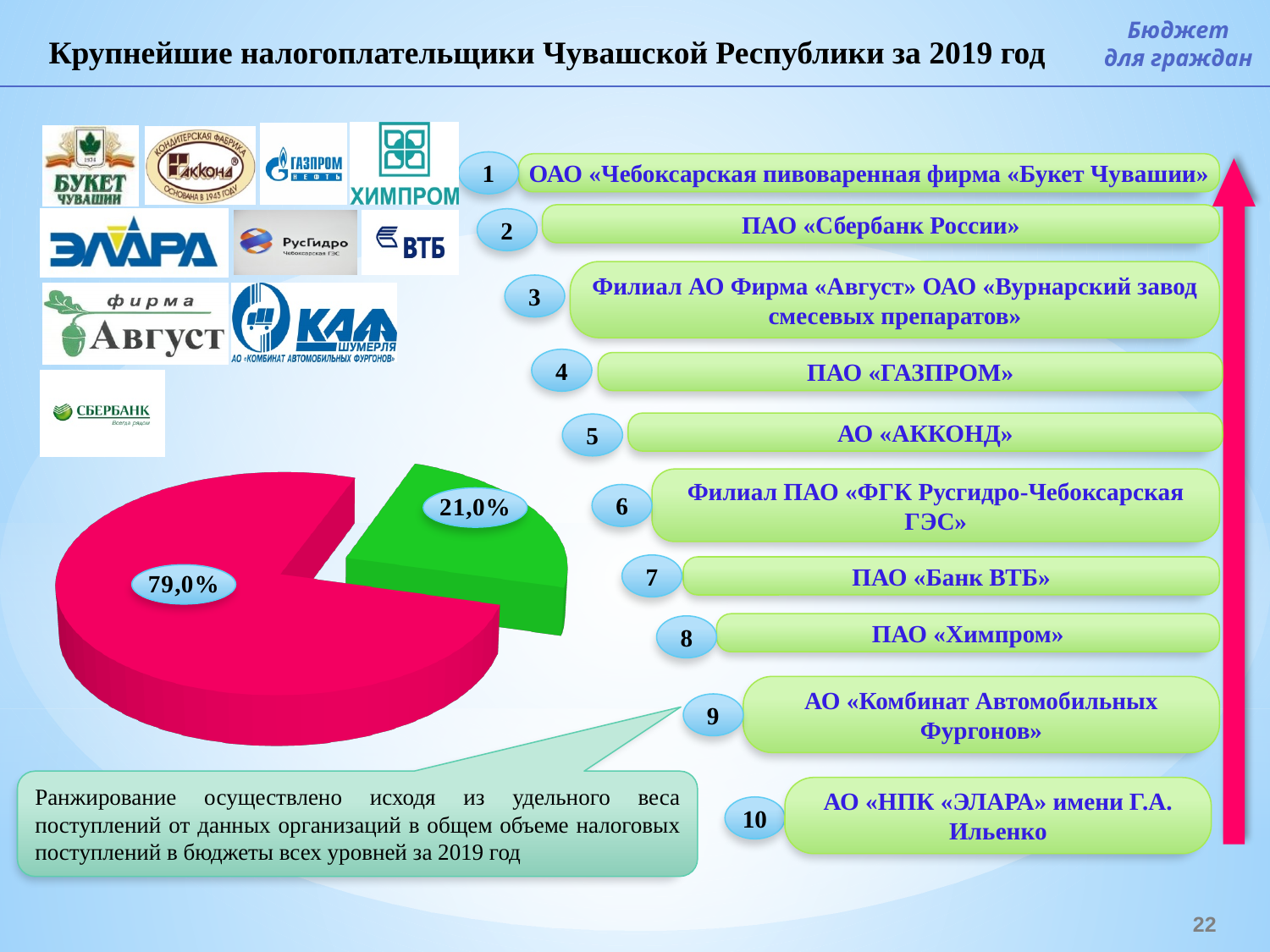
What is the difference between the pink slice and the green slice of the pie chart? 58,0% Which slice of the pie chart is pulled out (exploded) from the rest? the green slice (21,0%) What value is shown on the pink slice of the pie chart? 79,0% Which slice of the pie chart is the smallest? the green slice (21,0%) What kind of chart is shown on the slide? pie chart Does the pie chart have a legend? no What value is shown on the green slice of the pie chart? 21,0% What is the total of the two slices shown in the pie chart? 100,0% Which is larger in the pie chart, the pink slice or the green slice? the pink slice How many slices does the pie chart have? 2 Which slice of the pie chart is the largest? the pink slice (79,0%)